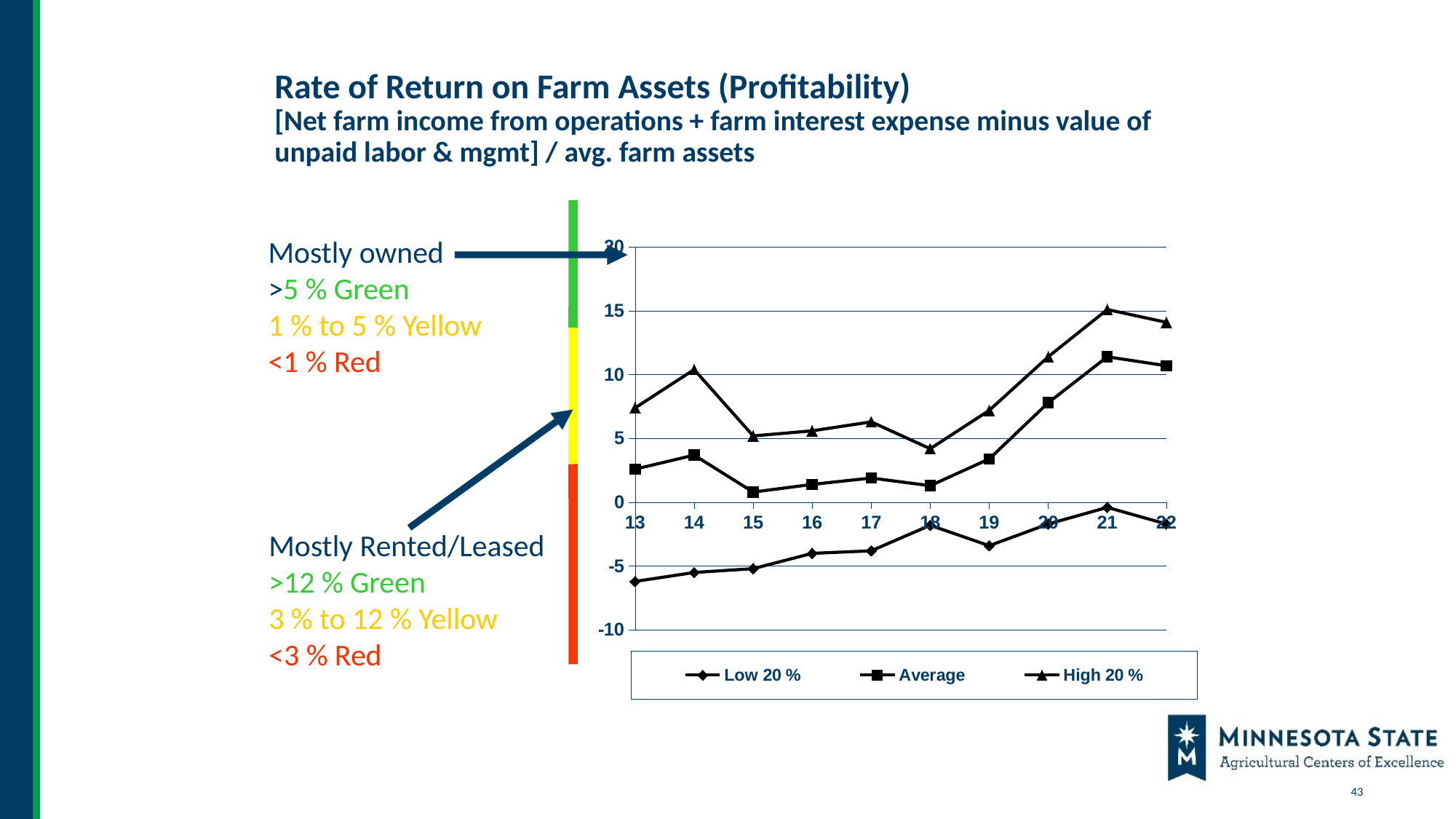
In which year does the High 20 % series have its lowest value? 18 How many series does the chart legend list? 3 In which year does the Low 20 % series have its lowest value? 13 Is the value for High 20 % in year 22 greater or less than 15? less What kind of chart is shown on the slide? Line chart Is the value for Low 20 % in year 13 greater or less than -5? less Is the value for Average in year 21 greater or less than 10? greater How many years are plotted along the x axis of the chart? 10 Which is larger for the High 20 % series: the value in year 14 or the value in year 15? Year 14 In which year does the High 20 % series reach its highest value? 21 Which series is shown with triangle markers in the legend? High 20 % Does the Low 20 % series generally rise or fall from year 13 to year 22? Rise